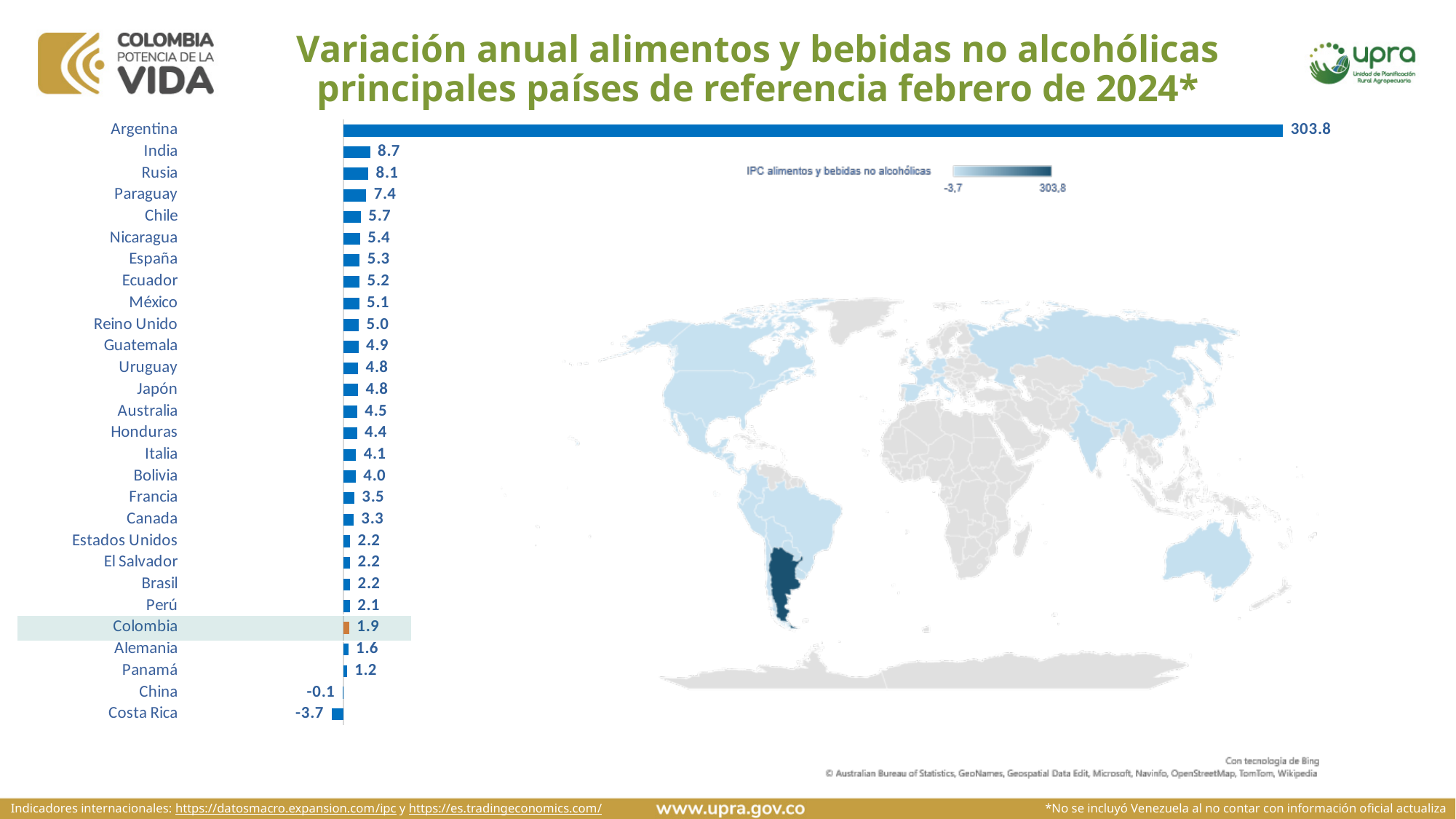
In the bar chart, which country's bar is coloured orange instead of blue? Colombia In the bar chart, what is the value for Colombia? 1.9 In the bar chart, what is the difference between the values for India and Paraguay? 1.3 In the bar chart, which country has the lowest value? Costa Rica In the bar chart, what is the value for Rusia? 8.1 In the bar chart, which country has the highest value? Argentina In the bar chart, what is the value for Costa Rica? -3.7 In the bar chart, what is the value for China? -0.1 In the bar chart, what is the value for Argentina? 303.8 What kind of chart is on the left side of the slide? Bar chart In the bar chart, which has a larger value, Chile or Alemania? Chile How many countries are shown in the bar chart? 28